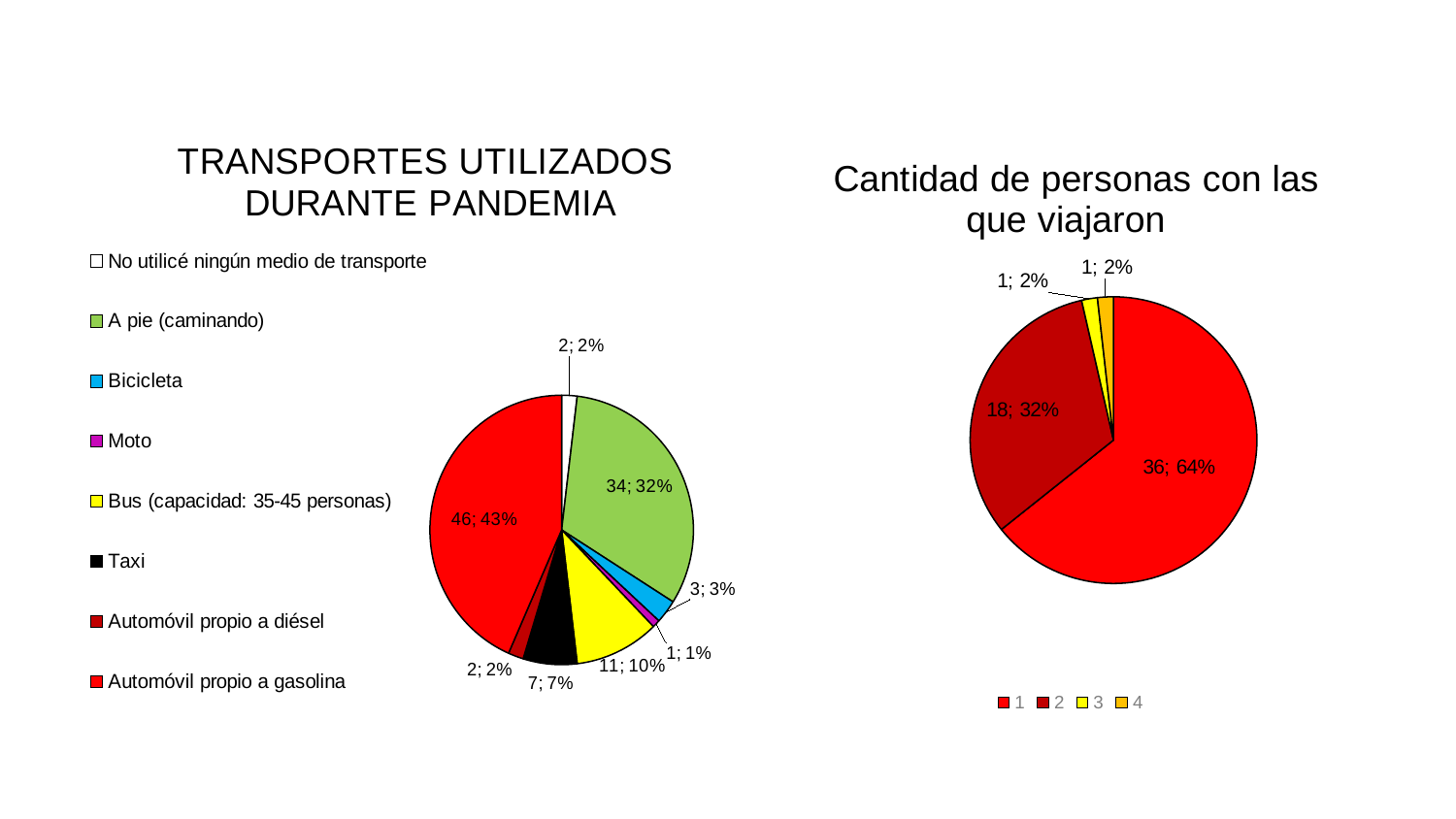
In the chart 'TRANSPORTES UTILIZADOS DURANTE PANDEMIA', which is larger: 'Bicicleta' or 'Taxi'? Taxi In the chart 'TRANSPORTES UTILIZADOS DURANTE PANDEMIA', what value is shown for 'A pie (caminando)'? 34; 32% In the chart 'Cantidad de personas con las que viajaron', what share of the pie does category '1' represent? 64% In the chart 'TRANSPORTES UTILIZADOS DURANTE PANDEMIA', which category has the smallest slice? Moto In the chart 'TRANSPORTES UTILIZADOS DURANTE PANDEMIA', what share of the pie does 'Taxi' represent? 7% In the chart 'Cantidad de personas con las que viajaron', what colour is the slice for category '3'? Yellow In the chart 'TRANSPORTES UTILIZADOS DURANTE PANDEMIA', which category has the largest slice? Automóvil propio a gasolina How many categories does the legend of the chart 'TRANSPORTES UTILIZADOS DURANTE PANDEMIA' list? 8 In the chart 'Cantidad de personas con las que viajaron', what value is shown for category '2'? 18; 32% In the chart 'TRANSPORTES UTILIZADOS DURANTE PANDEMIA', what value is shown for 'Bus (capacidad: 35-45 personas)'? 11; 10% In the chart 'TRANSPORTES UTILIZADOS DURANTE PANDEMIA', what is the difference between the counts for 'Automóvil propio a gasolina' and 'A pie (caminando)'? 12 What type of chart is 'Cantidad de personas con las que viajaron'? Pie chart